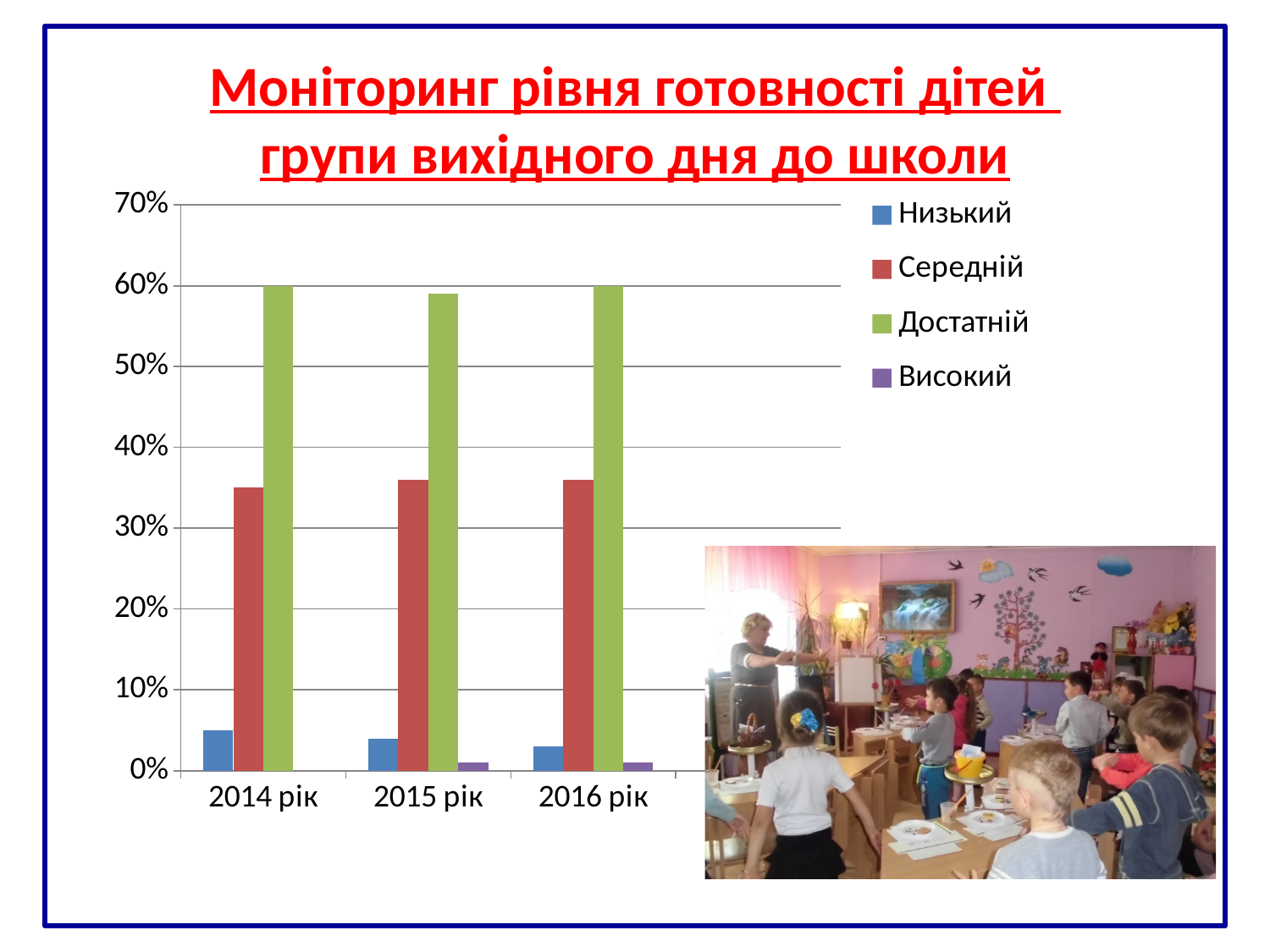
How many year categories are shown on the x axis? 3 What is the value for Достатній in 2014 рік? 60% Which is larger in 2014 рік, Середній or Достатній? Достатній Which level has the highest value in 2014 рік? Достатній How many series does the legend list? 4 Is the value for Достатній in 2015 рік greater or less than 50%? greater Is the value for Низький in 2014 рік greater or less than 10%? less Which colour represents the Достатній series in the legend? green Is the value for Середній in 2016 рік greater or less than 30%? greater What kind of chart is shown on the slide? bar chart Which level has the lowest value in 2015 рік? Високий